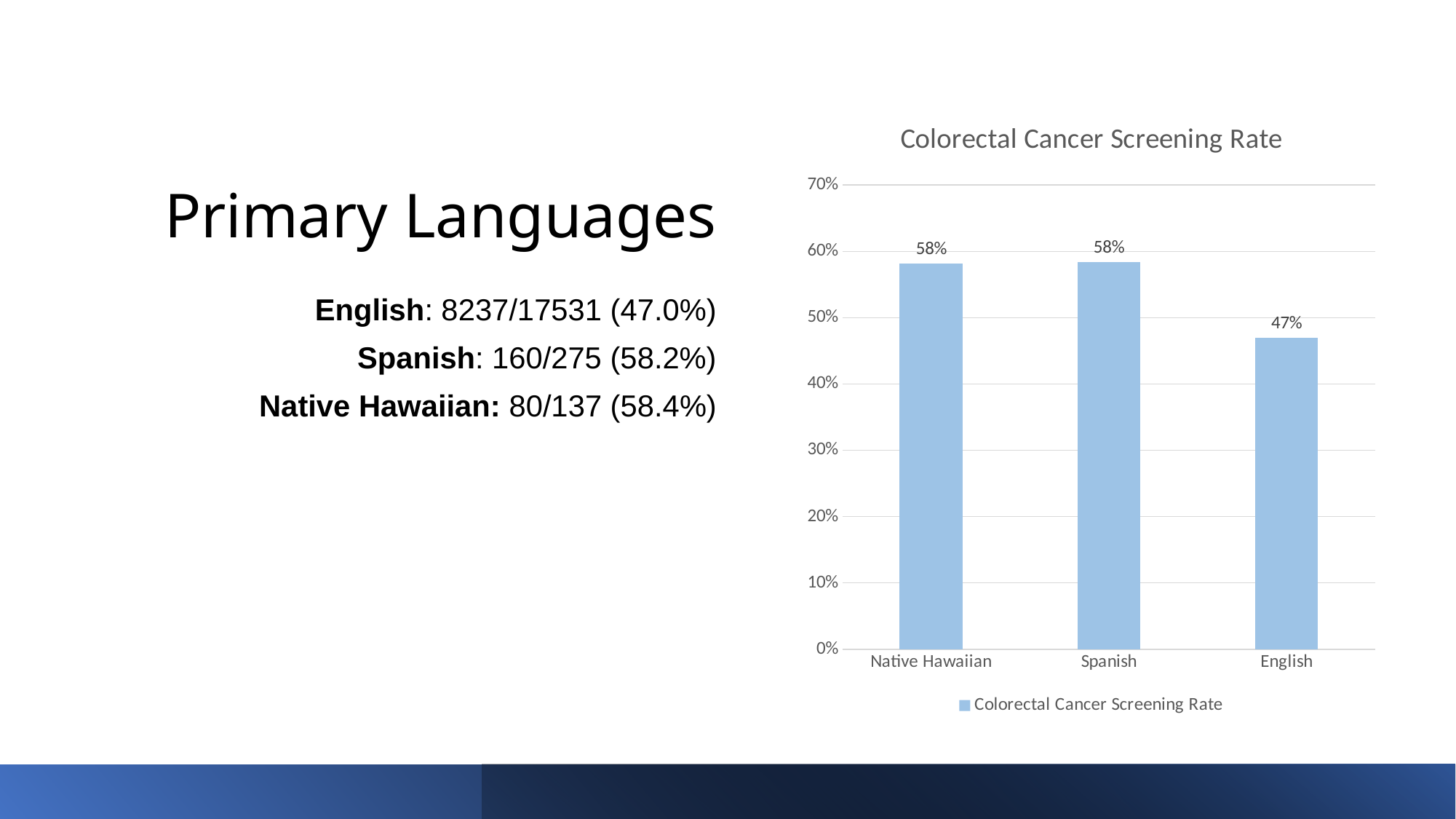
What is the Colorectal Cancer Screening Rate for Native Hawaiian? 58% What is the Colorectal Cancer Screening Rate for English? 47% What kind of chart is shown on the slide? bar chart Is the value for Native Hawaiian greater or less than 50%? greater How many categories are shown on the x axis of the chart? 3 What is the title of the chart? Colorectal Cancer Screening Rate What is the difference between the screening rate for Native Hawaiian and the screening rate for English? 11% Which has a higher Colorectal Cancer Screening Rate, Spanish or English? Spanish Which category has the lowest Colorectal Cancer Screening Rate? English Is the value for English greater or less than 50%? less What is the Colorectal Cancer Screening Rate for Spanish? 58% How many series does the chart's legend list? 1